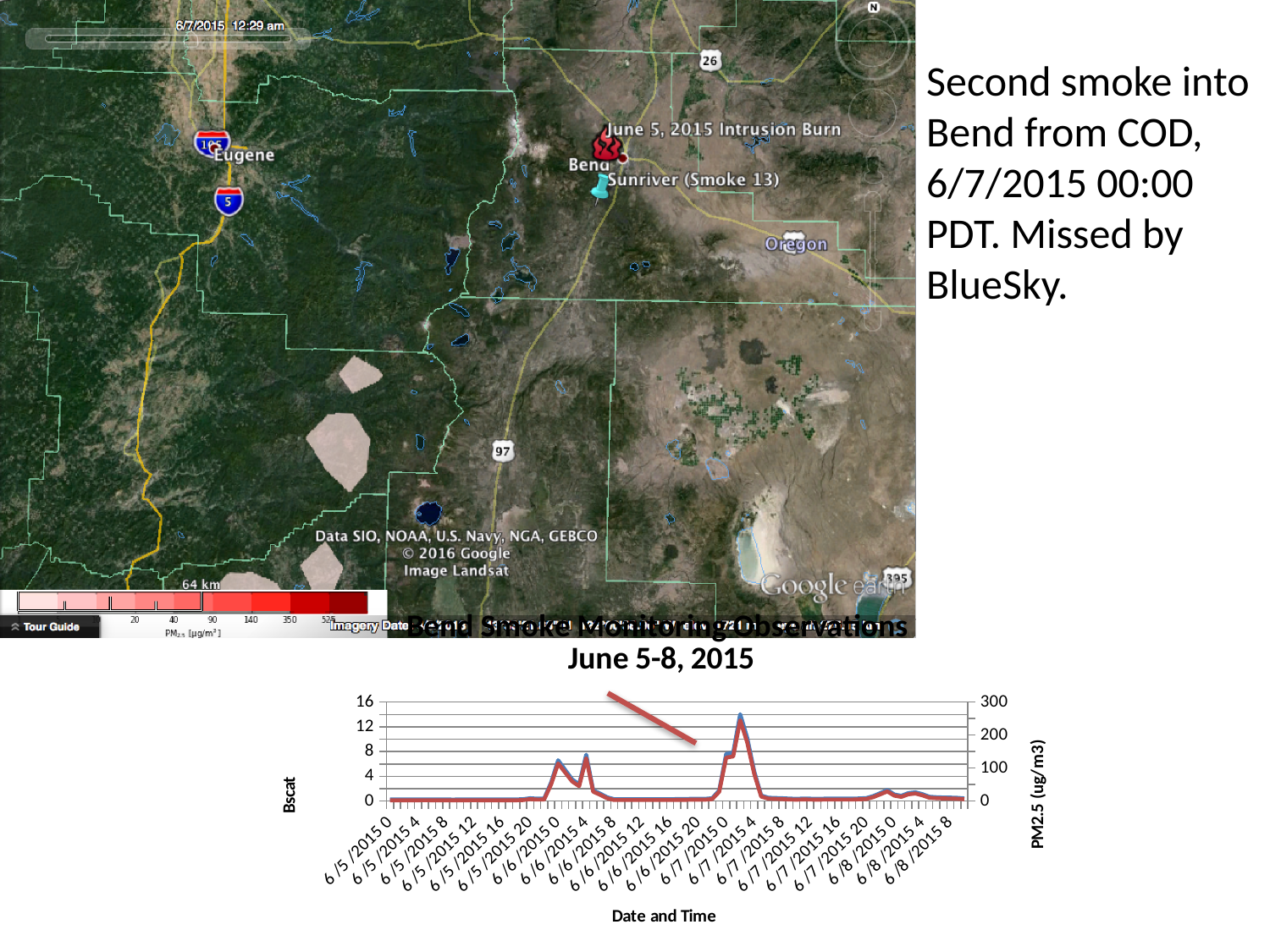
What is the maximum value shown on the right (PM2.5) axis of the chart? 300 How many lines are plotted on the chart? 2 Is the Bscat value at 6/5/2015 0 greater or less than 4? less Do the values rise or fall between 6/7/2015 4 and 6/7/2015 8? fall What is the title of the chart at the bottom of the slide? Bend Smoke Monitoring Observations June 5-8, 2015 Is the peak near 6/7/2015 higher or lower than the peak near 6/6/2015 0? higher What kind of chart is shown at the bottom of the slide? line chart On which date does the highest peak in the chart occur? 6/7/2015 What is the label of the x axis of the chart? Date and Time Is the Bscat value at the peak near 6/6/2015 0 greater or less than 8? less Is the Bscat value at the highest peak of the chart greater or less than 12? greater What is the maximum value shown on the left (Bscat) axis of the chart? 16